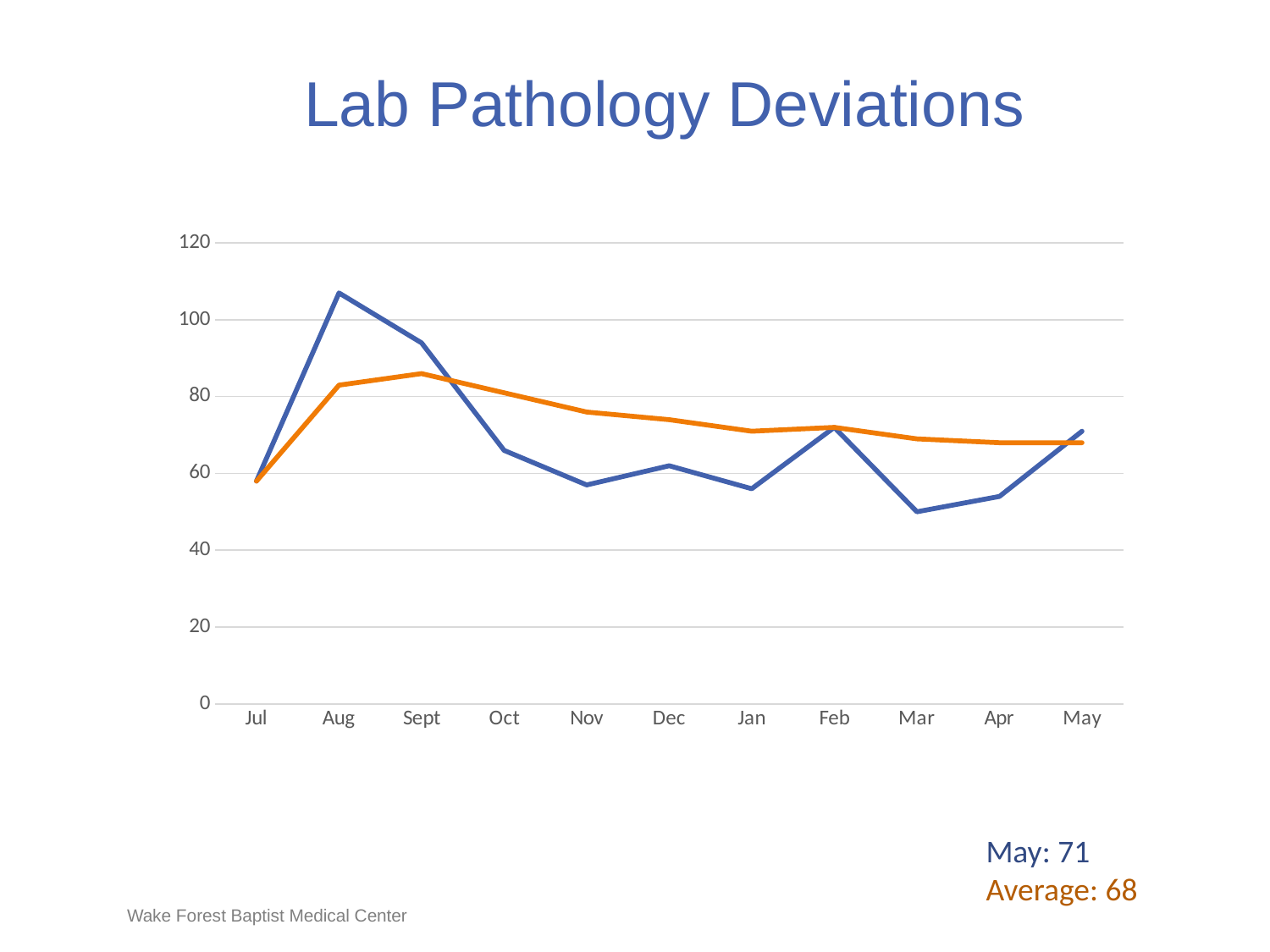
Which month has the larger value on the blue line, Feb or Mar? Feb What is the value of the blue line for May, as noted on the slide? 71 Does the orange average line rise or fall from Sept to Apr? fall What is the value of the orange average line for May, as noted on the slide? 68 By how much does the May value exceed the average noted on the slide? 3 In which month does the blue line reach its highest point? Aug How many lines are plotted on the chart? 2 Is the value of the blue line for Aug greater or less than 100? greater What is the title of the chart? Lab Pathology Deviations What kind of chart is shown on the slide? line chart How many months are plotted along the x axis? 11 In which month does the blue line reach its lowest point? Mar